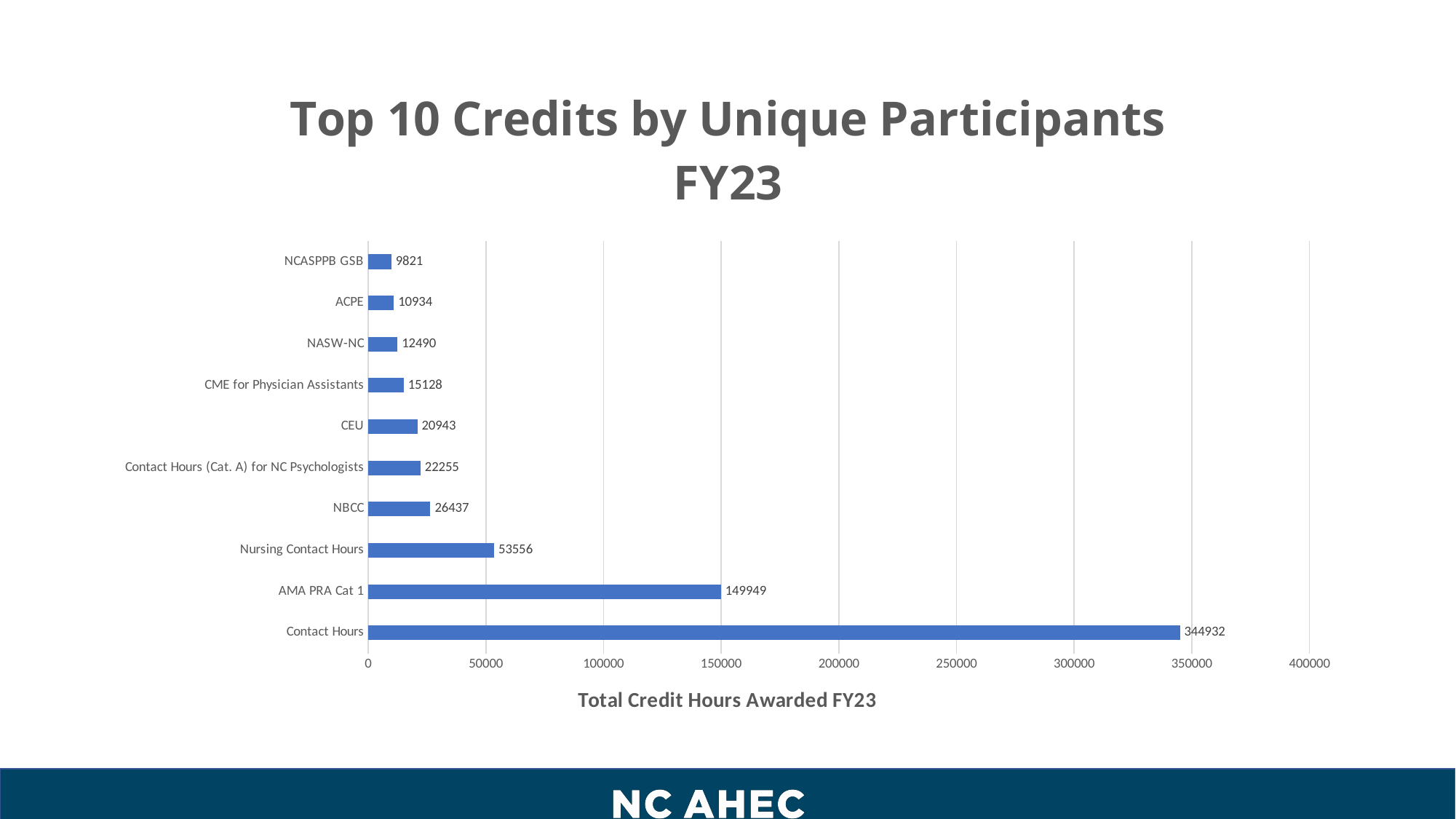
Is the value for Nursing Contact Hours greater or less than 50000? greater What is the difference between the values for Contact Hours and AMA PRA Cat 1? 194983 What is the value for AMA PRA Cat 1? 149949 How many categories are shown in the chart? 10 Which category has the lowest value? NCASPPB GSB What is the value for Nursing Contact Hours? 53556 What is the x-axis title of the chart? Total Credit Hours Awarded FY23 Which category has the highest value? Contact Hours Which is larger, the value for CEU or the value for NASW-NC? CEU What kind of chart is this? bar chart What is the value for Contact Hours? 344932 What is the value for NBCC? 26437